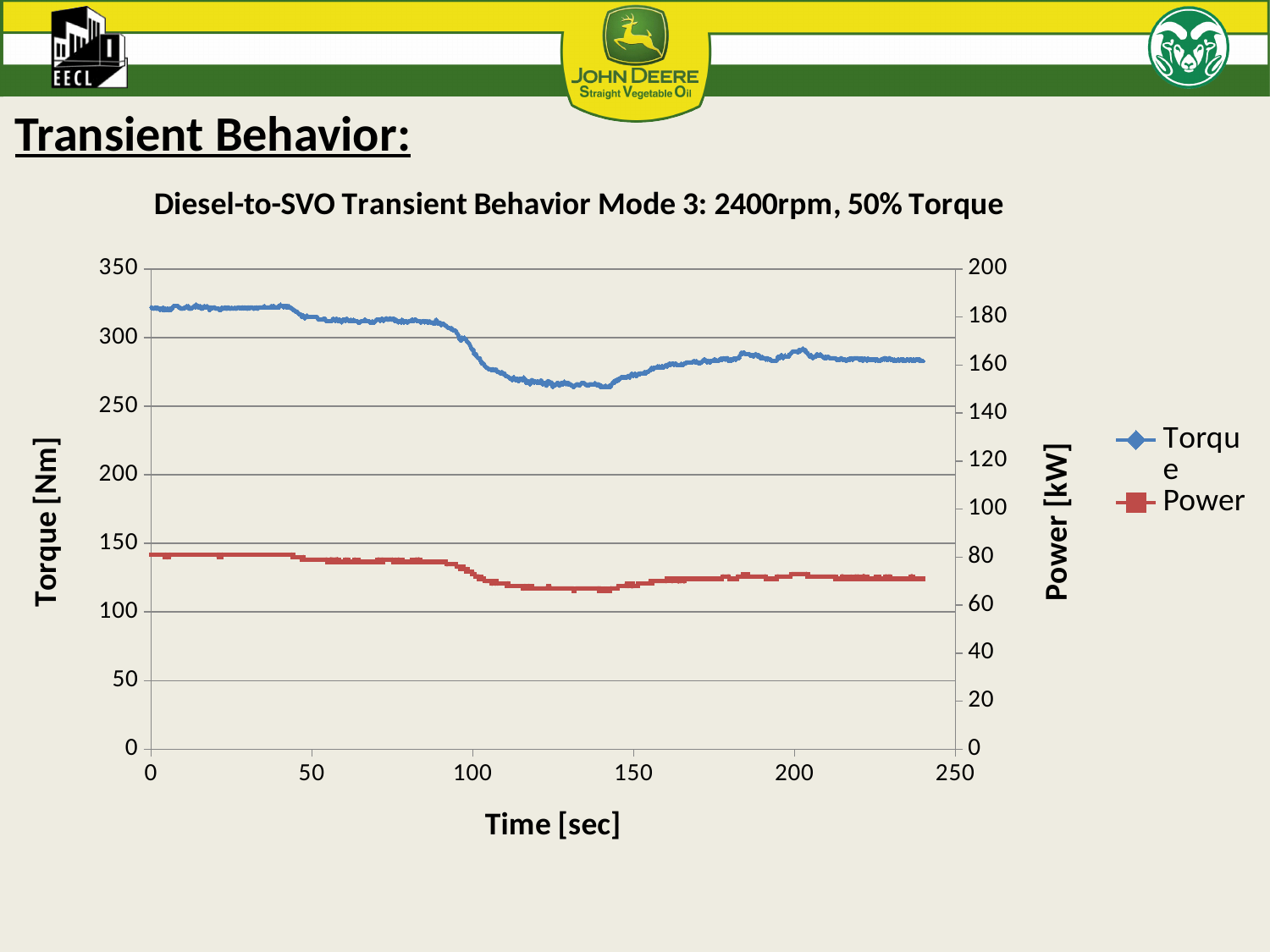
Is the Torque value larger at 0 sec or at 130 sec? 0 sec Is the Torque value at time 130 sec greater or less than 250 Nm? greater What is the label of the x axis? Time [sec] Is the Power value at time 0 sec greater or less than 60 kW? greater Does the Torque series rise or fall between 0 sec and 150 sec? fall Is the Power value larger at 0 sec or at 130 sec? 0 sec Is the Torque value at time 0 sec greater or less than 300 Nm? greater What kind of chart is shown on the slide? Line chart What is the title of the chart? Diesel-to-SVO Transient Behavior Mode 3: 2400rpm, 50% Torque How many series does the legend list? 2